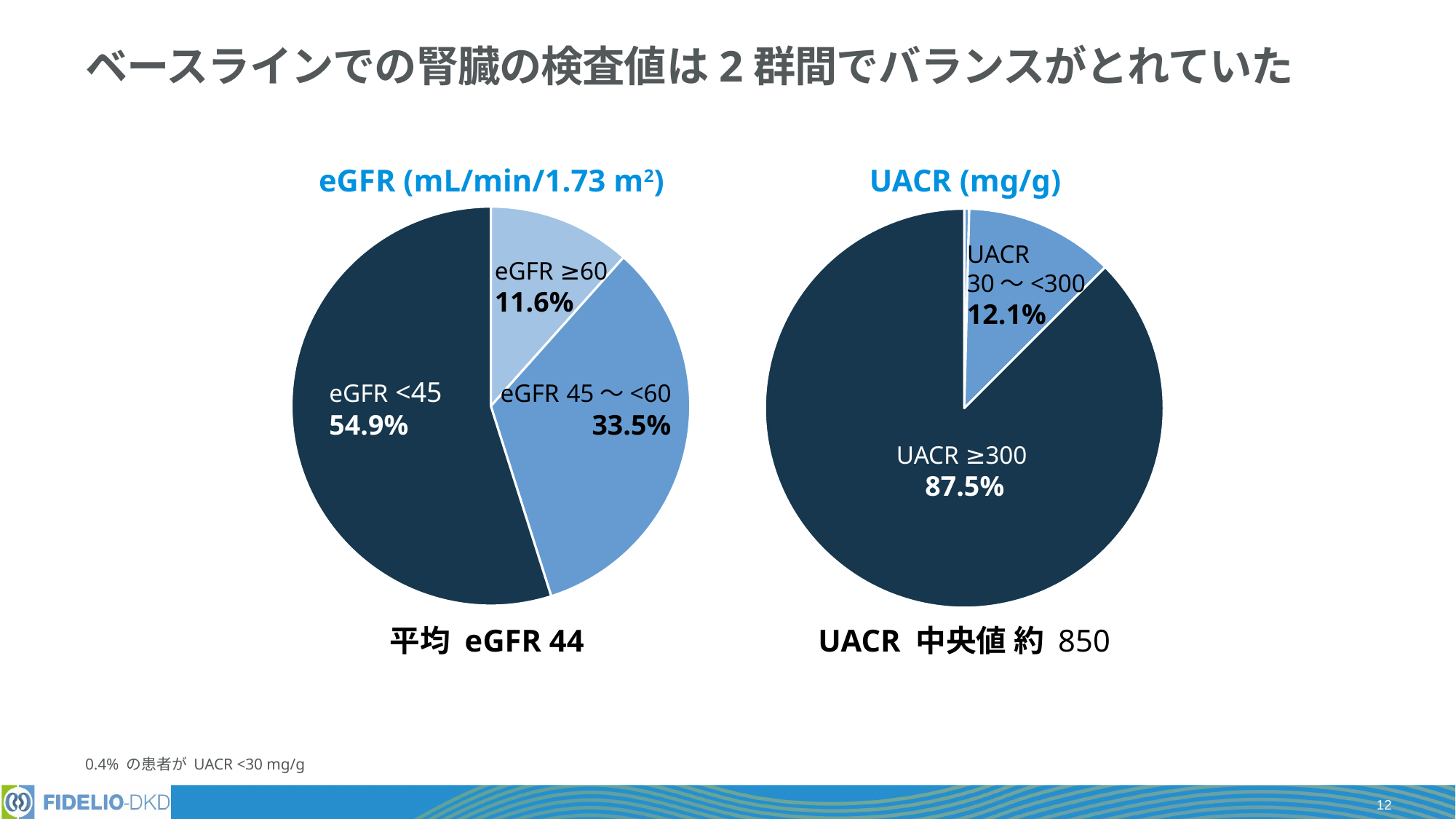
In the eGFR (mL/min/1.73 m²) pie chart, what share of patients had eGFR 45 to <60? 33.5% What type of chart is used for the UACR (mg/g) data? Pie chart How many categories are shown in the eGFR (mL/min/1.73 m²) pie chart? 3 In the UACR (mg/g) pie chart, what share of patients had UACR 30 to <300? 12.1% In the eGFR (mL/min/1.73 m²) pie chart, what is the difference in percentage points between the eGFR <45 share and the eGFR 45 to <60 share? 21.4 In the eGFR (mL/min/1.73 m²) pie chart, which category has the smallest share? eGFR ≥60 In the eGFR (mL/min/1.73 m²) pie chart, which category has the largest share? eGFR <45 In the UACR (mg/g) pie chart, what share of patients had UACR ≥300? 87.5% In the UACR (mg/g) pie chart, what is the difference in percentage points between the UACR ≥300 share and the UACR 30 to <300 share? 75.4 In the eGFR (mL/min/1.73 m²) pie chart, what share of patients had eGFR ≥60? 11.6% In the UACR (mg/g) pie chart, which labelled category has the largest share? UACR ≥300 In the eGFR (mL/min/1.73 m²) pie chart, what share of patients had eGFR <45? 54.9%